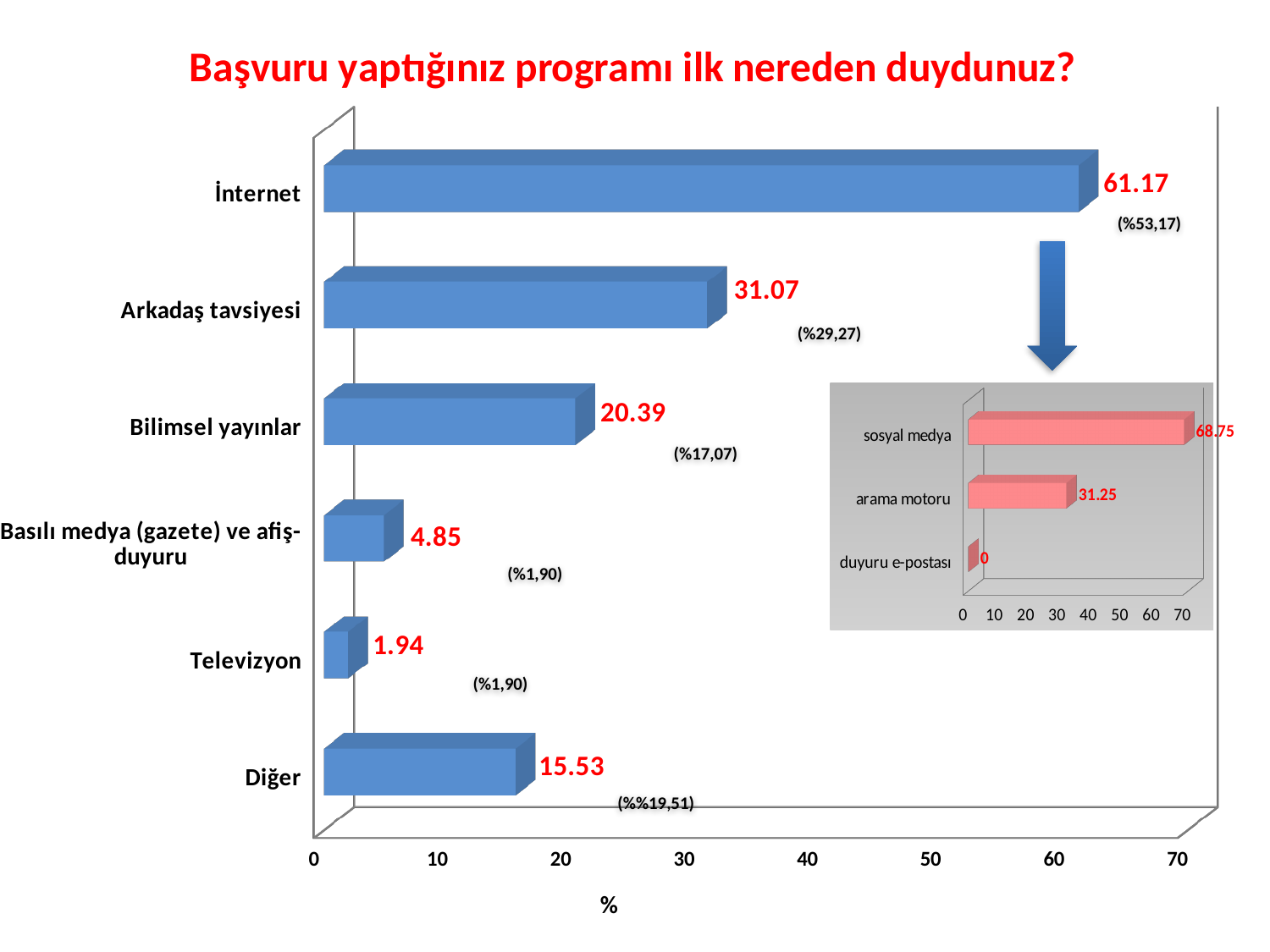
In the main chart titled 'Başvuru yaptığınız programı ilk nereden duydunuz?', what is the value for Arkadaş tavsiyesi? 31.07 In the main chart titled 'Başvuru yaptığınız programı ilk nereden duydunuz?', which is larger: Bilimsel yayınlar or Diğer? Bilimsel yayınlar In the small inset chart on the right side of the slide, what is the value for duyuru e-postası? 0 What kind of chart is the main chart titled 'Başvuru yaptığınız programı ilk nereden duydunuz?'? Bar chart In the main chart titled 'Başvuru yaptığınız programı ilk nereden duydunuz?', what is the value for İnternet? 61.17 In the main chart titled 'Başvuru yaptığınız programı ilk nereden duydunuz?', what is the difference between the values for İnternet and Arkadaş tavsiyesi? 30.1 In the main chart titled 'Başvuru yaptığınız programı ilk nereden duydunuz?', which category has the highest value? İnternet How many categories does the main chart titled 'Başvuru yaptığınız programı ilk nereden duydunuz?' show? 6 In the small inset chart on the right side of the slide, what is the value for sosyal medya? 68.75 In the small inset chart on the right side of the slide, what is the difference between the values for sosyal medya and arama motoru? 37.5 In the main chart titled 'Başvuru yaptığınız programı ilk nereden duydunuz?', what is the value for Televizyon? 1.94 In the main chart titled 'Başvuru yaptığınız programı ilk nereden duydunuz?', which category has the lowest value? Televizyon